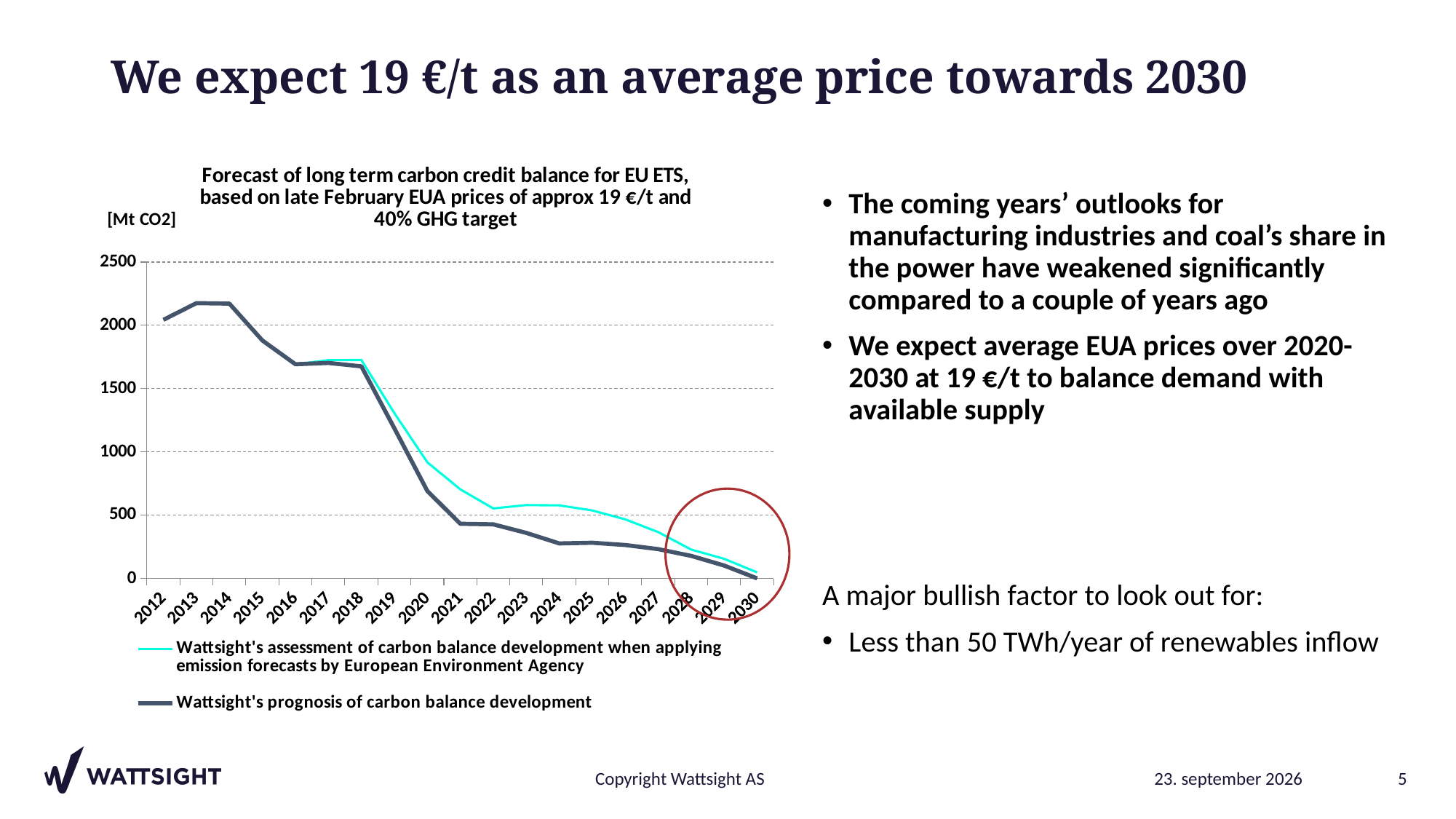
How many series does the legend list? 2 In which year does Wattsight's prognosis of carbon balance development reach its lowest value? 2030 Is the value of Wattsight's prognosis of carbon balance development in 2016 greater or less than 1500? greater What kind of chart is shown on the slide? line chart In 2020, which series has the higher value: Wattsight's assessment based on European Environment Agency forecasts or Wattsight's prognosis of carbon balance development? Wattsight's assessment based on European Environment Agency forecasts Is the value of Wattsight's assessment based on European Environment Agency forecasts in 2024 greater or less than 500? greater Is the value of Wattsight's prognosis of carbon balance development in 2021 greater or less than 500? less Which year is the first on the x axis and which is the last? 2012 and 2030 Do the values of Wattsight's prognosis of carbon balance development rise or fall from 2014 to 2030? fall What unit is shown for the y axis of the chart? [Mt CO2] How many years are shown on the x axis of the chart? 19